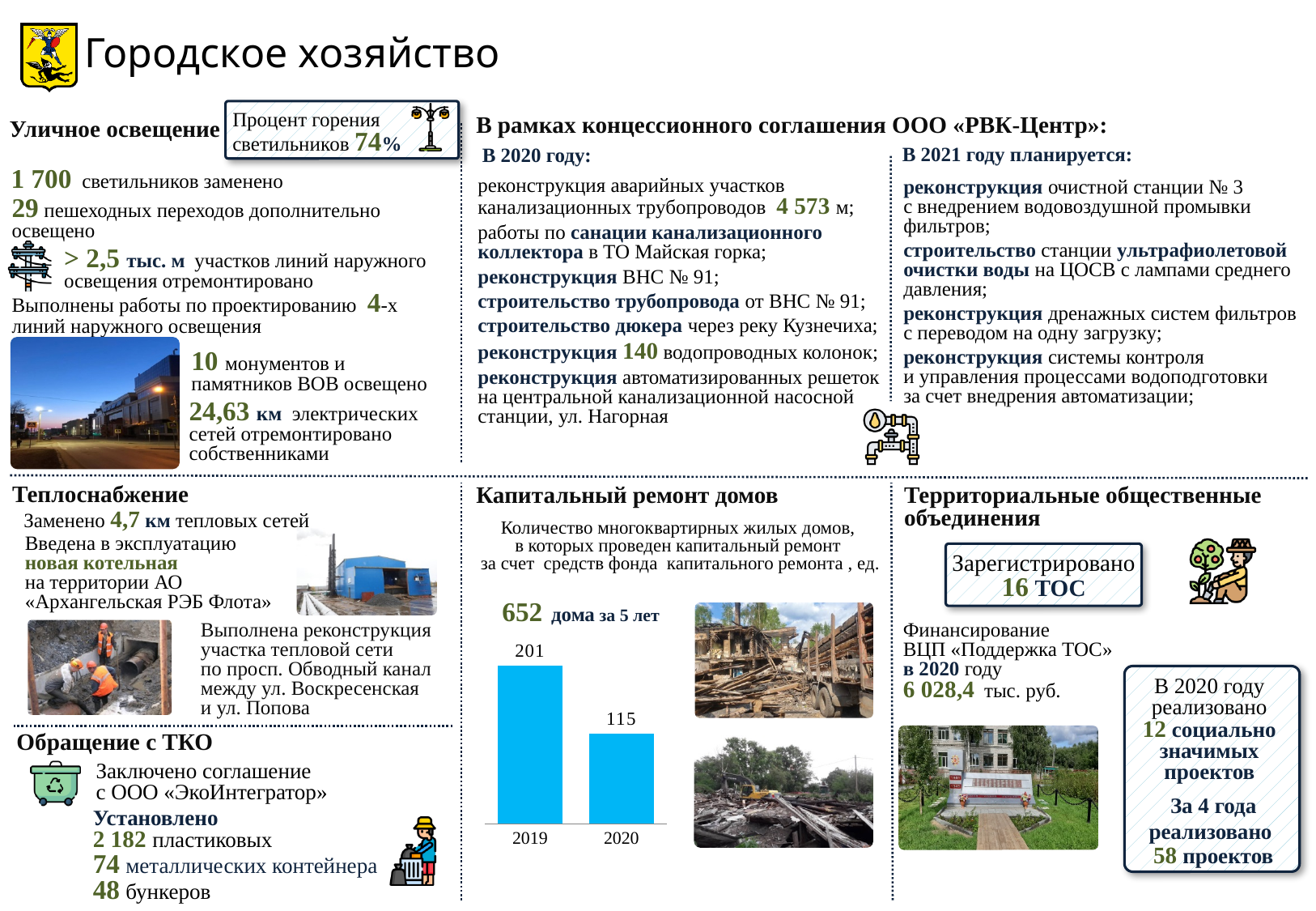
In the bar chart, what is the value for 2019? 201 What unit is stated in the bar chart's title for the number of houses? ед. What type of chart is shown in the 'Капитальный ремонт домов' section? bar chart What is the total of the two values shown in the bar chart? 316 What is the difference between the 2019 and 2020 values in the bar chart? 86 Do the values in the bar chart rise or fall from 2019 to 2020? fall How many bars are shown in the bar chart? 2 In the bar chart, what is the value for 2020? 115 Which year has the higher value in the bar chart? 2019 Is the value for 2020 larger or smaller than the value for 2019 in the bar chart? smaller What colour are the bars in the bar chart? blue Which year has the lower value in the bar chart? 2020